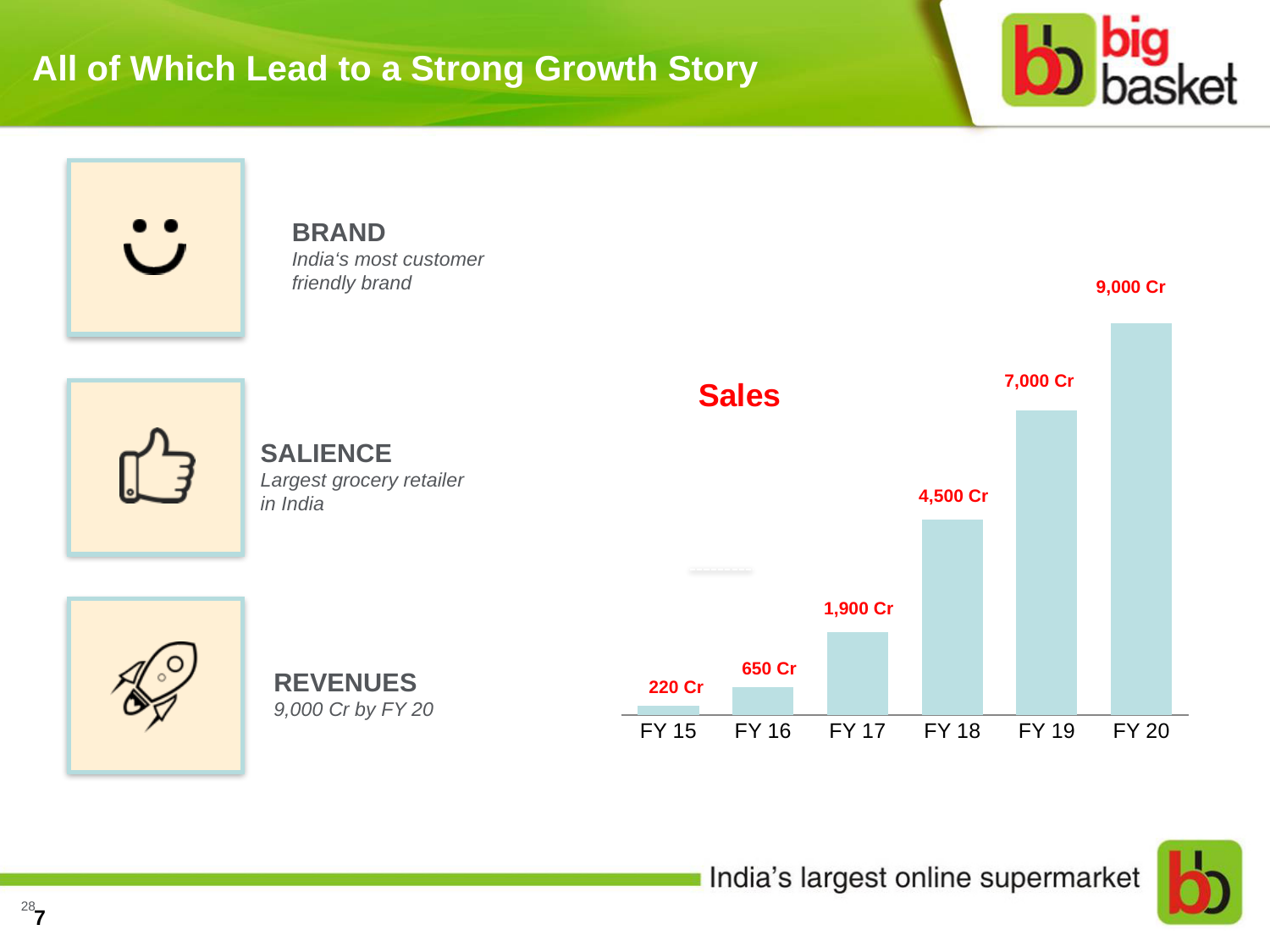
Which fiscal year has the lowest sales? FY 15 What is the difference in sales between FY 20 and FY 19? 2,000 Cr What is the sales value for FY 19? 7,000 Cr What is the difference in sales between FY 18 and FY 17? 2,600 Cr Which fiscal year has the highest sales? FY 20 What is the title of the chart? Sales Do sales rise or fall from FY 15 to FY 20? Rise What is the sales value for FY 17? 1,900 Cr What is the sales value for FY 15? 220 Cr How many fiscal years are shown on the x axis? 6 What kind of chart is used to show sales? Bar chart Which is larger, sales in FY 16 or sales in FY 18? FY 18